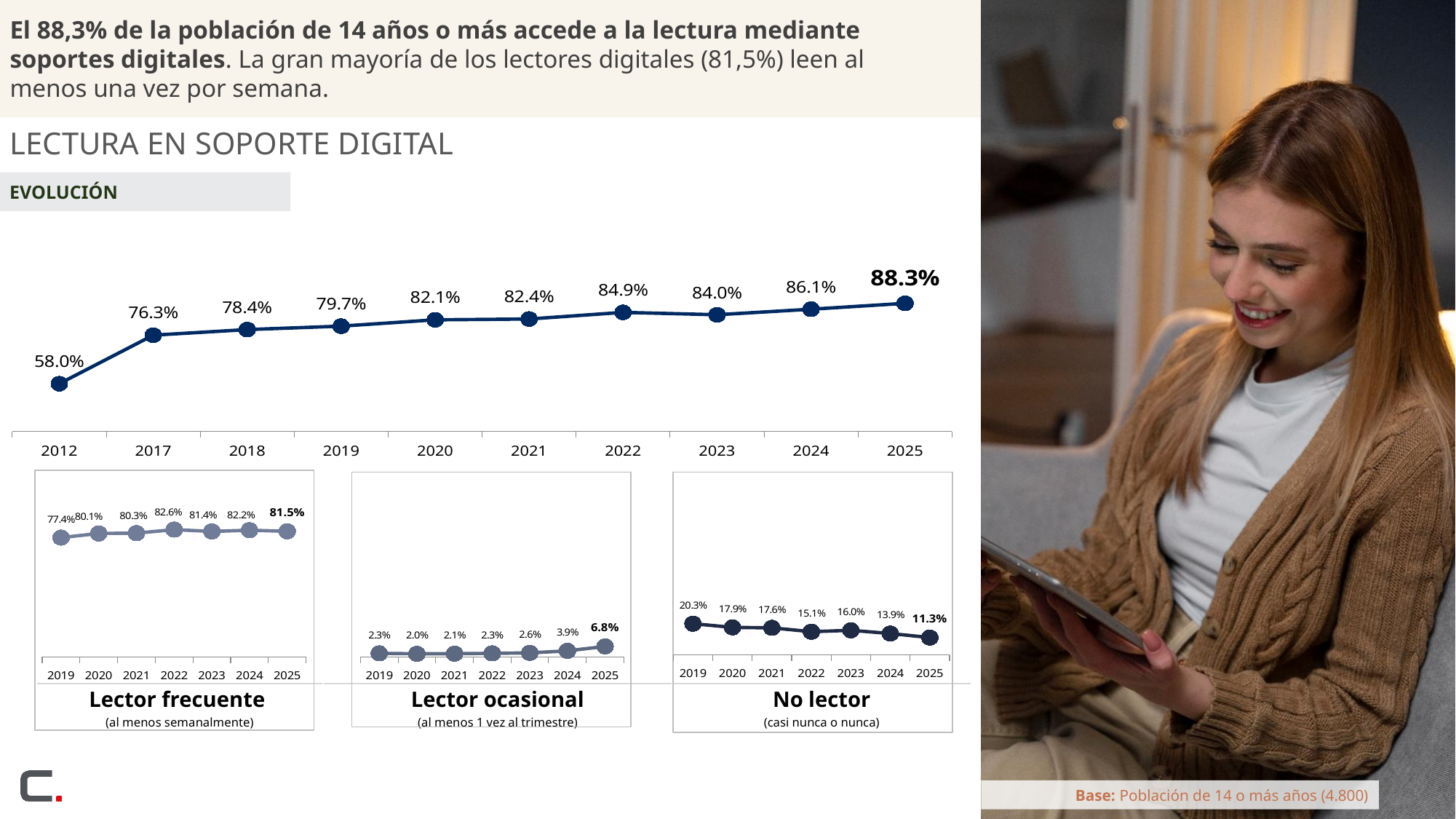
In the main 'Evolución' line chart, which year has the lowest value? 2012 In the main 'Evolución' line chart, what is the value for 2012? 58.0% In the main 'Evolución' line chart, what is the value for 2025? 88.3% In the 'Lector frecuente' chart, what is the value for 2022? 82.6% In the 'No lector' chart, do the values generally rise or fall from 2019 to 2025? fall In the main 'Evolución' line chart, what is the difference between the 2025 value and the 2024 value? 2.2% In the main 'Evolución' line chart, is the value for 2022 larger or smaller than the value for 2023? larger In the 'No lector' chart, what is the value for 2019? 20.3% In the main 'Evolución' line chart, how many data points are plotted? 10 In the 'Lector ocasional' chart, which year has the highest value? 2025 What type of chart is the main 'Evolución' chart? line chart In the 'Lector ocasional' chart, what is the difference between the 2025 value and the 2024 value? 2.9%